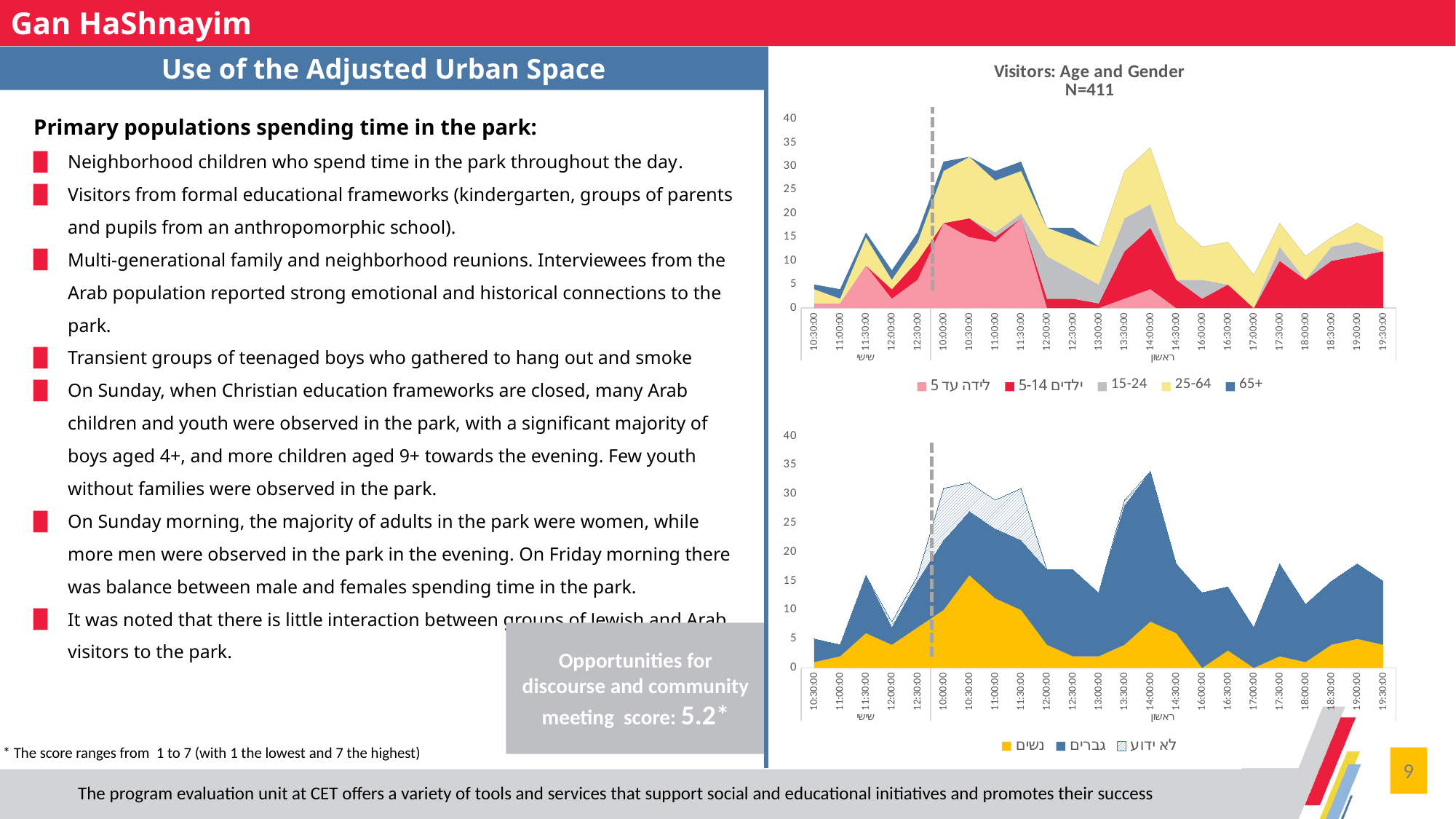
In the bottom chart, is the total number of visitors at 12:30:00 on ראשון greater or less than 20? less In the top chart, is the total number of visitors at 14:00:00 on ראשון greater or less than 30? greater What is the N value shown in the title of the top chart? N=411 How many series does the legend of the top chart (Visitors: Age and Gender) list? 5 In the top chart, does the total number of visitors rise or fall between 16:00:00 and 17:00:00? fall How many series does the legend of the bottom chart list? 3 What kind of chart is the top chart titled 'Visitors: Age and Gender N=411'? Stacked area chart How many time points are shown along the x axis of the bottom chart? 23 What is the highest value shown on the y axis of the top chart? 40 In the bottom chart, does the total number of visitors rise or fall between 13:00:00 and 14:00:00? rise In the bottom chart, is the total number of visitors at 14:00:00 on ראשון greater or less than 30? greater